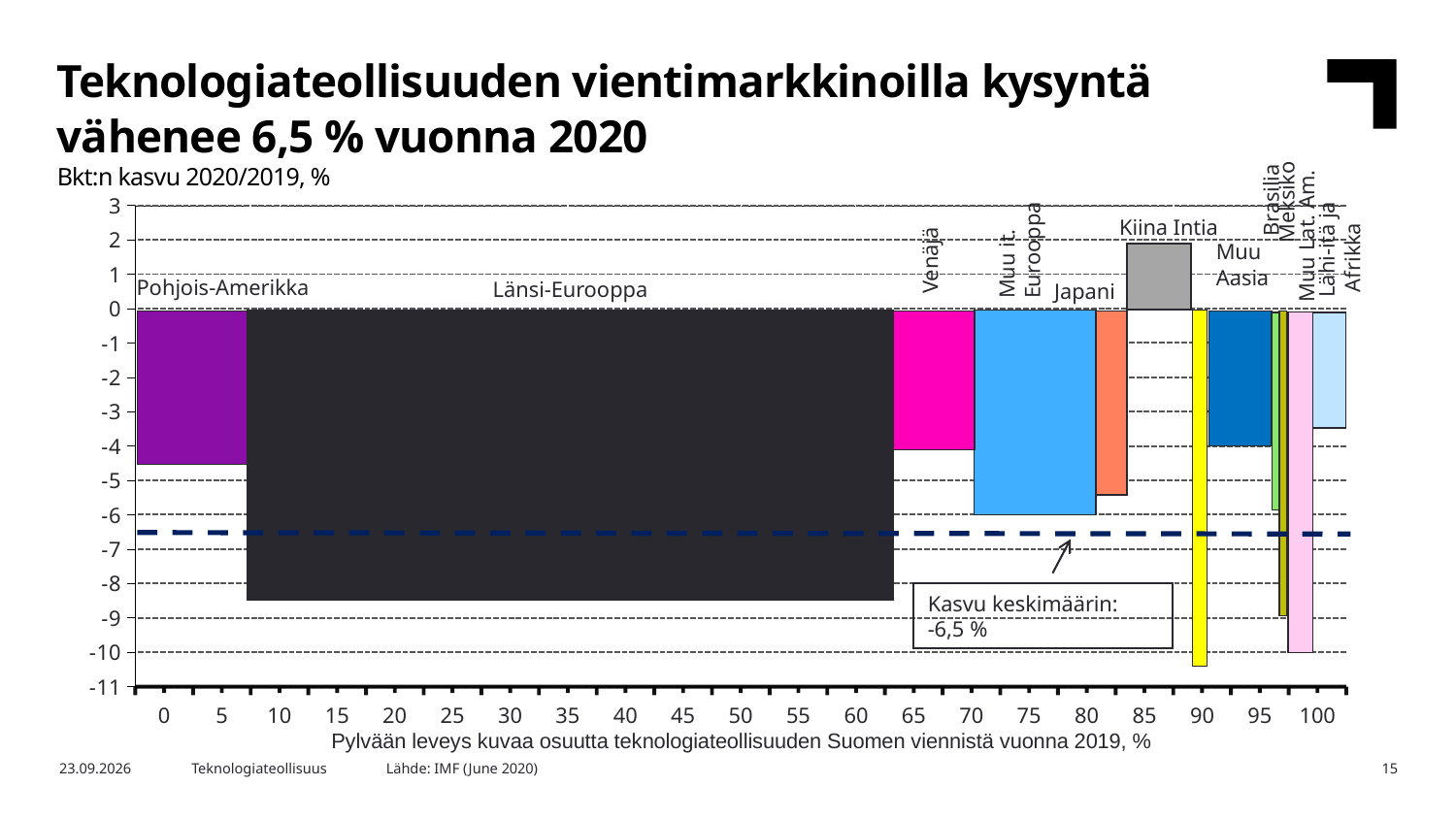
What does the width of each bar represent, according to the x-axis label? Share of Finland's technology industry exports in 2019, % Which has the higher GDP growth, Kiina or Japani? Kiina What kind of chart is shown on the slide? bar chart Is the value for Lähi-itä ja Afrikka greater or less than -4? greater Which has the higher GDP growth, Pohjois-Amerikka or Länsi-Eurooppa? Pohjois-Amerikka Is the value for Länsi-Eurooppa greater or less than -8? less Which region has the widest bar, i.e. the largest share of Finland's technology industry exports in 2019? Länsi-Eurooppa Is the value for Pohjois-Amerikka greater or less than -4? less What is the average growth (Kasvu keskimäärin) marked by the dashed line? -6,5 % Which region is the only one with positive GDP growth in the chart? Kiina